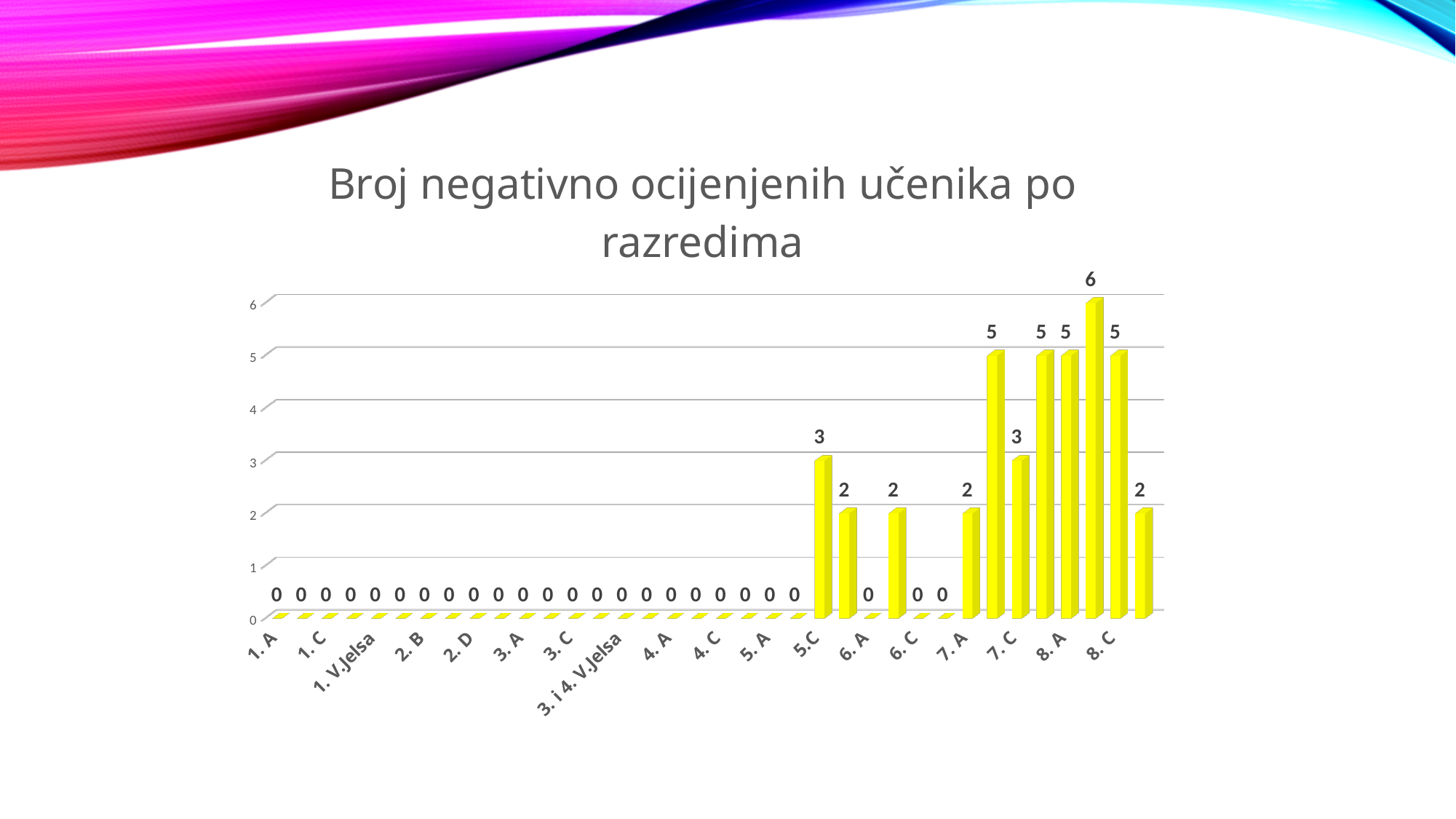
What is the highest value shown on the chart? 6 What is the value for 7. C? 3 What kind of chart is shown on the slide? Bar chart What is the value for 8. C? 5 What is the value for 7. A? 2 What is the title of the chart? Broj negativno ocijenjenih učenika po razredima What is the value for 5.C? 3 What is the value for 8. A? 5 What is the value for 1. A? 0 What is the difference between the values for 8. A and 7. A? 3 What is the value for 6. A? 0 Which has a larger value, 8. C or 7. C? 8. C